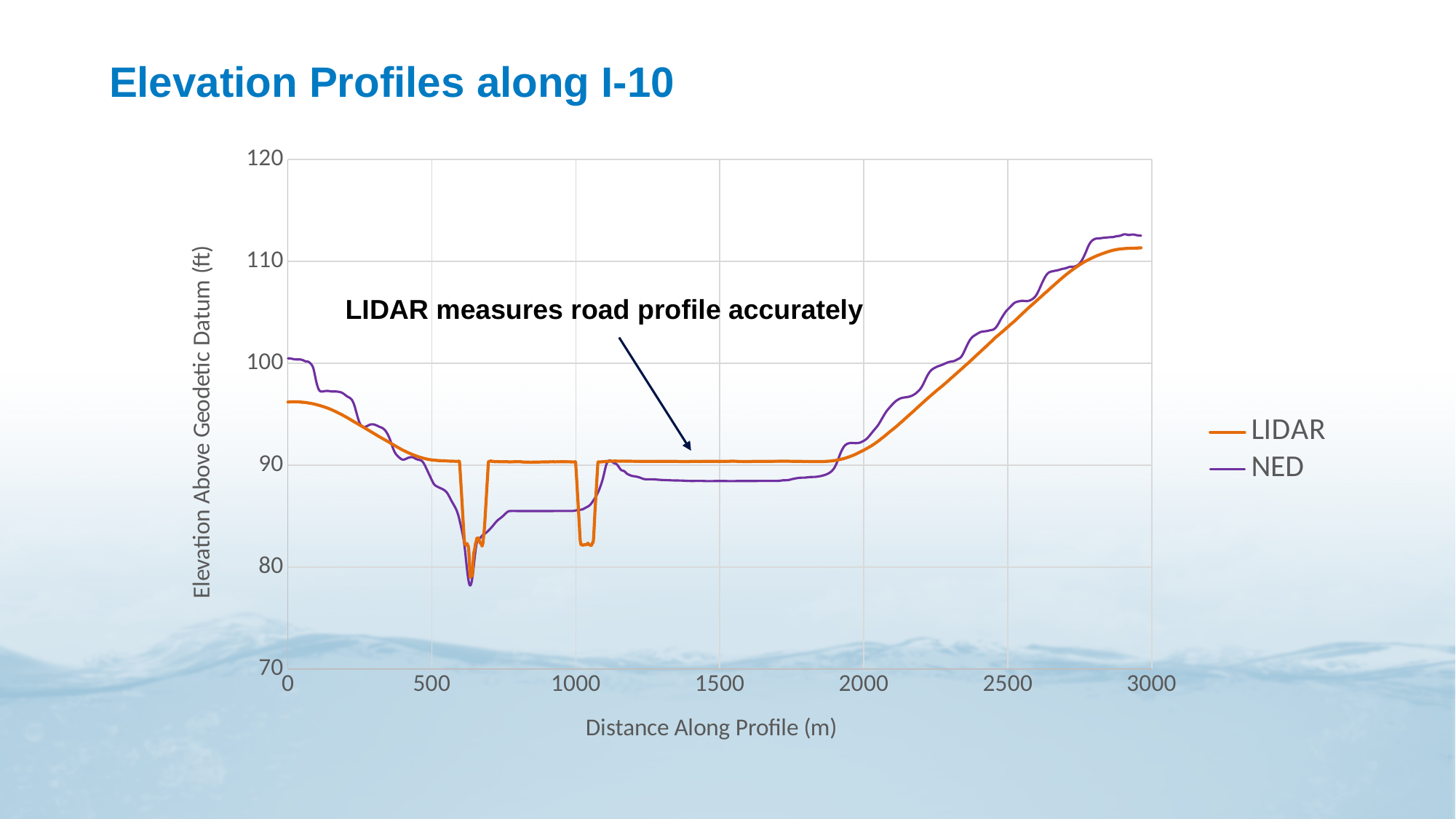
Is the NED elevation at the far right end of the profile (near 3000 m) greater or less than 110 ft? greater Is the lowest NED elevation on the profile greater or less than 80 ft? less What kind of chart is shown on the slide? Line chart At a distance of 0 m, which series shows the higher elevation, LIDAR or NED? NED Is the LIDAR elevation at a distance of 2500 m greater or less than 100 ft? greater At a distance of 900 m, which series shows the higher elevation, LIDAR or NED? LIDAR What are the two series named in the legend? LIDAR and NED What is the title of the chart on the slide? Elevation Profiles along I-10 How many series does the legend list? 2 Between 2000 m and 3000 m along the profile, does the LIDAR elevation rise or fall? rise